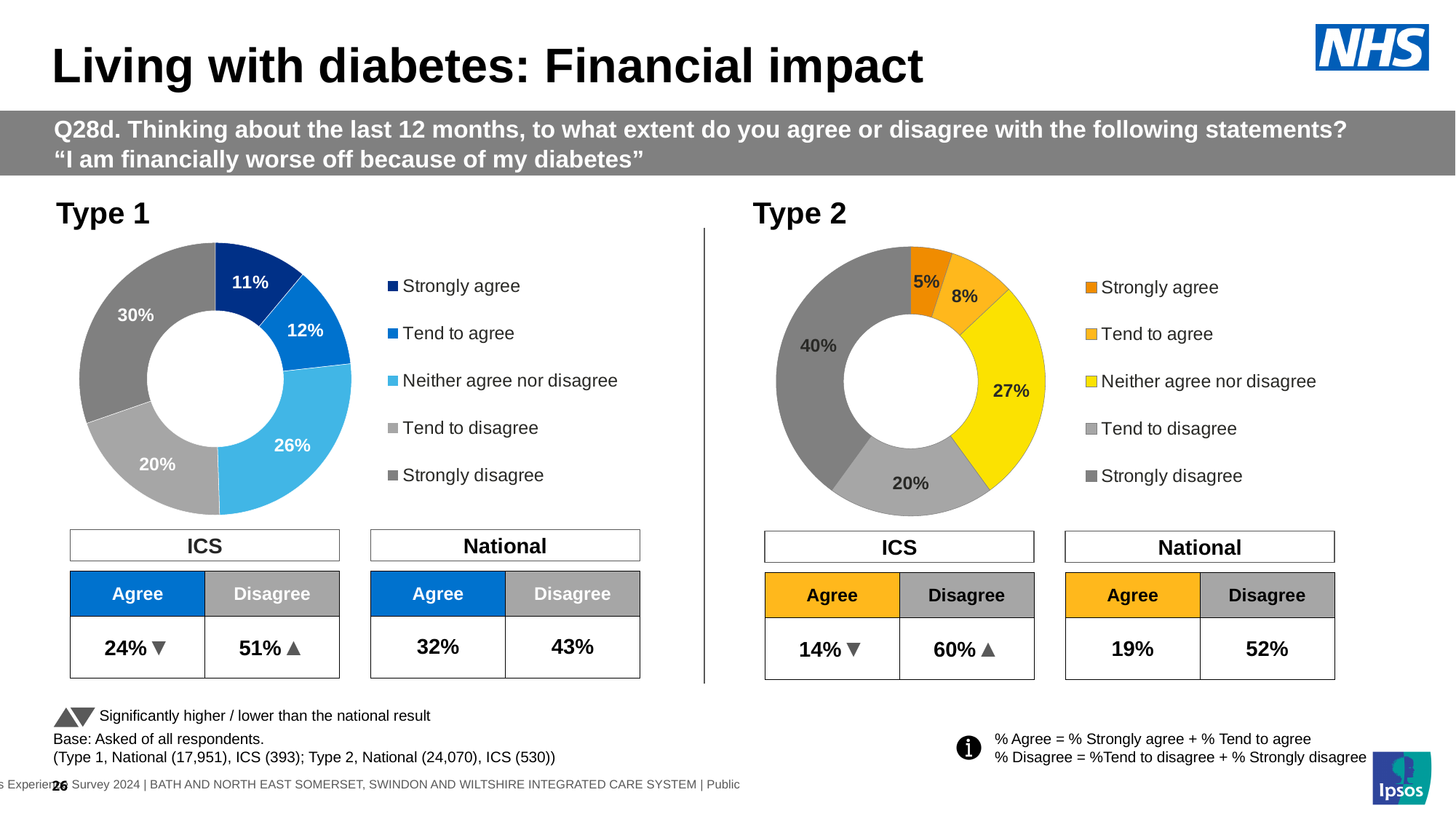
In the Type 2 chart, what is the difference between the 'Strongly disagree' and 'Tend to disagree' shares? 20% In the Type 1 chart, what percentage of respondents said 'Strongly agree'? 11% In the Type 2 chart, what colour represents 'Neither agree nor disagree'? Yellow In the Type 2 chart, which response category has the smallest share? Strongly agree In the Type 2 chart, what percentage of respondents said 'Neither agree nor disagree'? 27% In the Type 1 chart, what percentage of respondents said 'Tend to disagree'? 20% In the Type 1 chart, what is the combined share of 'Tend to disagree' and 'Strongly disagree'? 50% In the Type 2 chart, what is the combined share of 'Strongly agree' and 'Tend to agree'? 13% What kind of chart is used to show the Type 2 results? Doughnut chart How many response categories does the Type 1 chart's legend list? 5 In the Type 1 chart, which response category has the largest share? Strongly disagree In the Type 1 chart, which is larger: 'Tend to agree' or 'Neither agree nor disagree'? Neither agree nor disagree